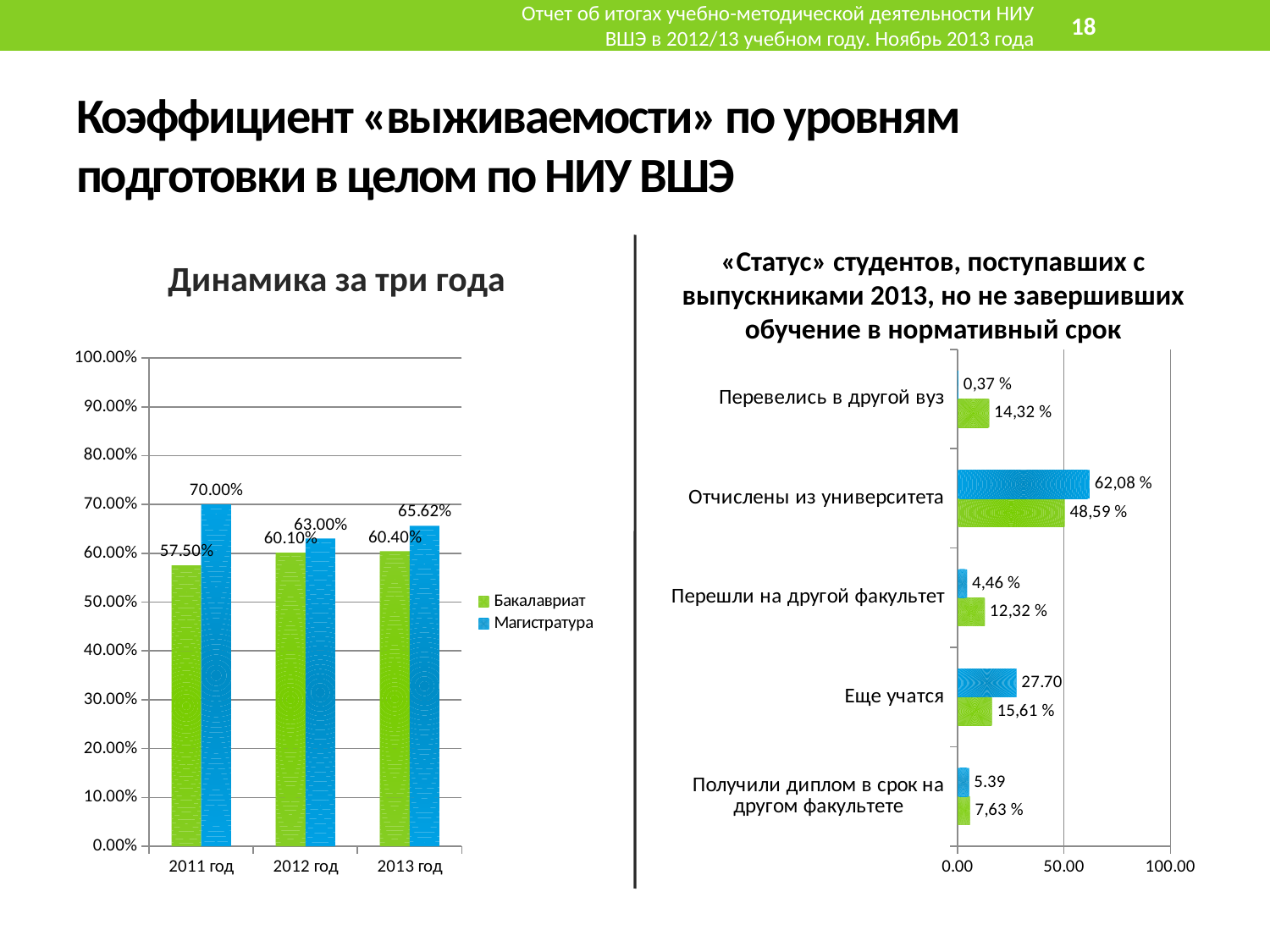
In the chart titled «Динамика за три года», how many series does the legend list? 2 In the chart on the right («Статус» студентов...), is the blue bar for Еще учатся greater or less than 50.00? less In the chart titled «Динамика за три года», what is the value for Бакалавриат in 2013 год? 60.40% In the chart on the right («Статус» студентов...), what is the value of the blue bar for Отчислены из университета? 62,08 % In the chart titled «Динамика за три года», what is the value for Магистратура in 2011 год? 70.00% In the chart on the right («Статус» студентов...), which category has the highest green bar value? Отчислены из университета In the chart titled «Динамика за три года», what kind of chart is shown? bar chart In the chart on the right («Статус» студентов...), how many categories are shown? 5 In the chart titled «Динамика за три года», which year has the lowest value for Бакалавриат? 2011 год In the chart titled «Динамика за три года», do the Бакалавриат values rise or fall from 2011 год to 2013 год? rise In the chart on the right («Статус» студентов...), what is the value of the green bar for Перевелись в другой вуз? 14,32 % In the chart titled «Динамика за три года», what is the difference between Магистратура and Бакалавриат in 2012 год? 2.90%